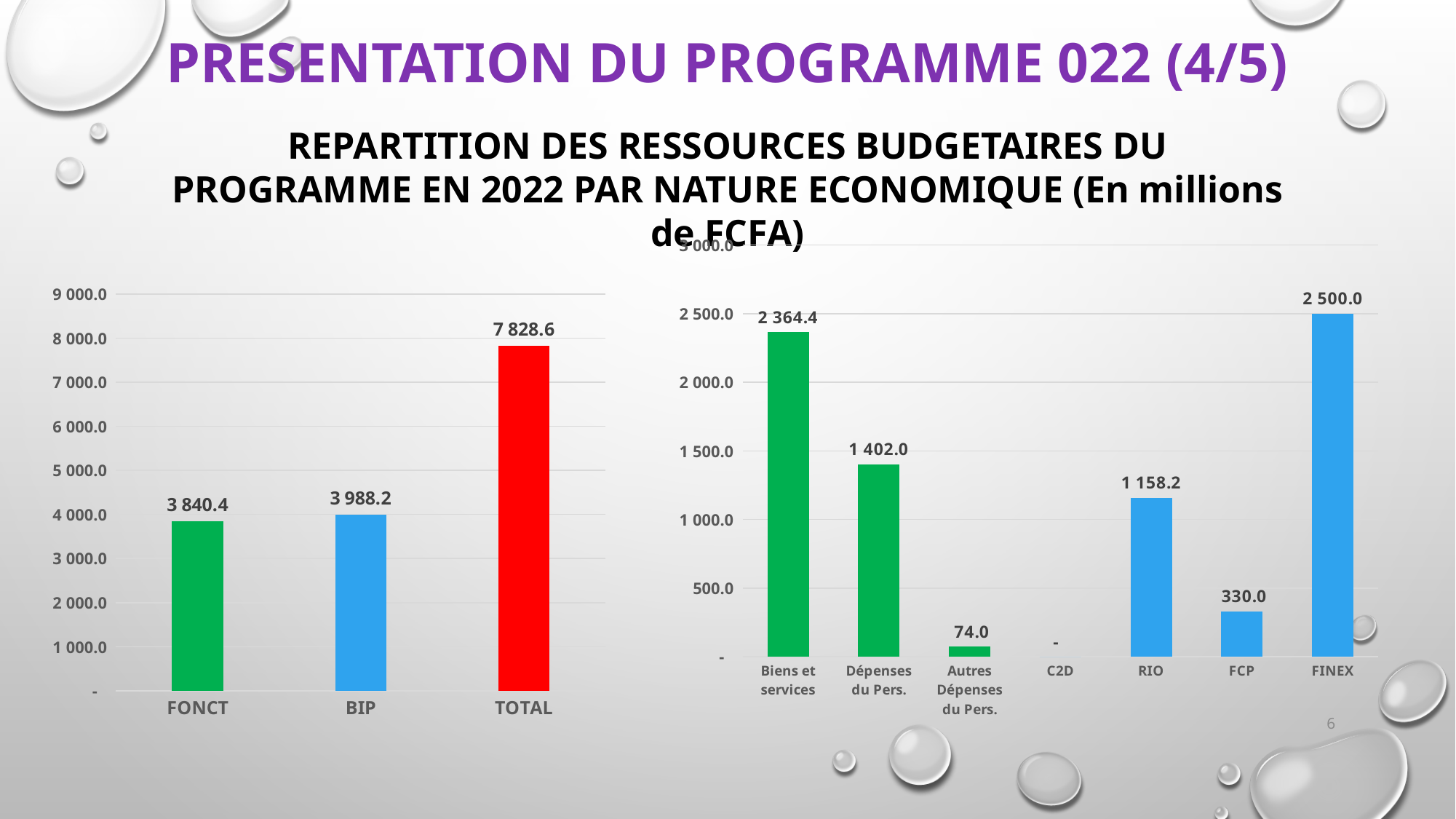
In the left chart, what colour is the TOTAL bar? red In the left chart, which is larger, FONCT or BIP? BIP In the left chart, what is the difference between BIP and FONCT? 147.8 In the left chart, what is the value for TOTAL? 7 828.6 In the right chart, which category has the highest value? FINEX In the right chart, what is the value for FINEX? 2 500.0 What type of chart is the left chart? bar chart How many categories are shown on the x axis of the right chart? 7 In the right chart, which category has the lowest value among those with a bar shown? Autres Dépenses du Pers. In the right chart, what is the value for Dépenses du Pers.? 1 402.0 In the left chart, what is the value for FONCT? 3 840.4 In the right chart, what is the difference between Biens et services and RIO? 1 206.2